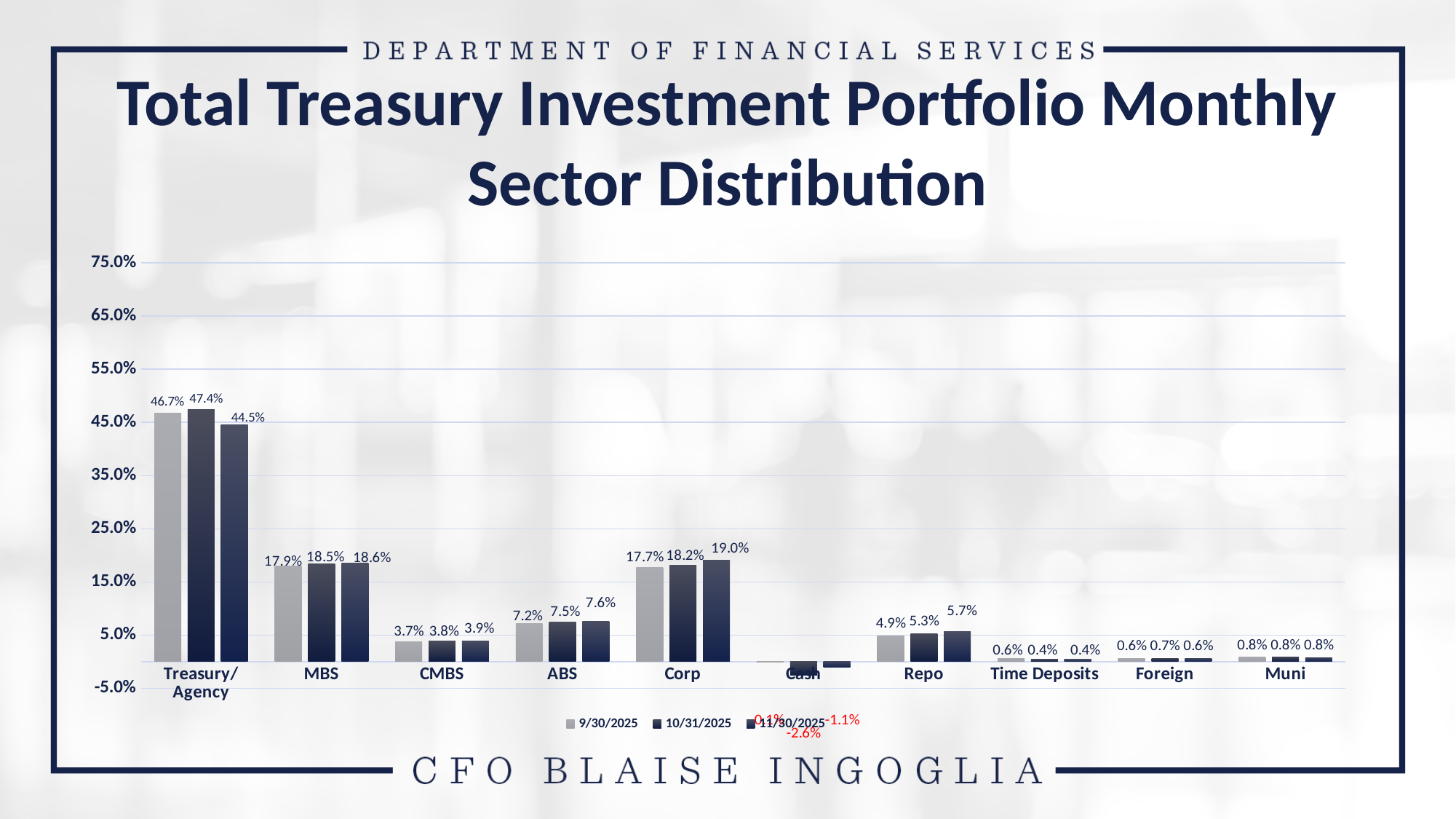
What is the title of the chart? Total Treasury Investment Portfolio Monthly Sector Distribution Which sector has the highest value for 10/31/2025? Treasury/Agency How many sector categories are shown on the x axis? 10 What is the difference between the Treasury/Agency values for 10/31/2025 and 11/30/2025? 2.9% What is the value for Corp for 10/31/2025? 18.2% Which is larger for 11/30/2025: MBS or Corp? Corp What kind of chart is shown on the slide? bar chart Is the value for ABS for 9/30/2025 greater or less than 5.0%? greater What is the value for Repo for 9/30/2025? 4.9% What is the value for Treasury/Agency for 11/30/2025? 44.5% Do the Corp values rise or fall from 9/30/2025 to 11/30/2025? rise How many series does the legend list? 3